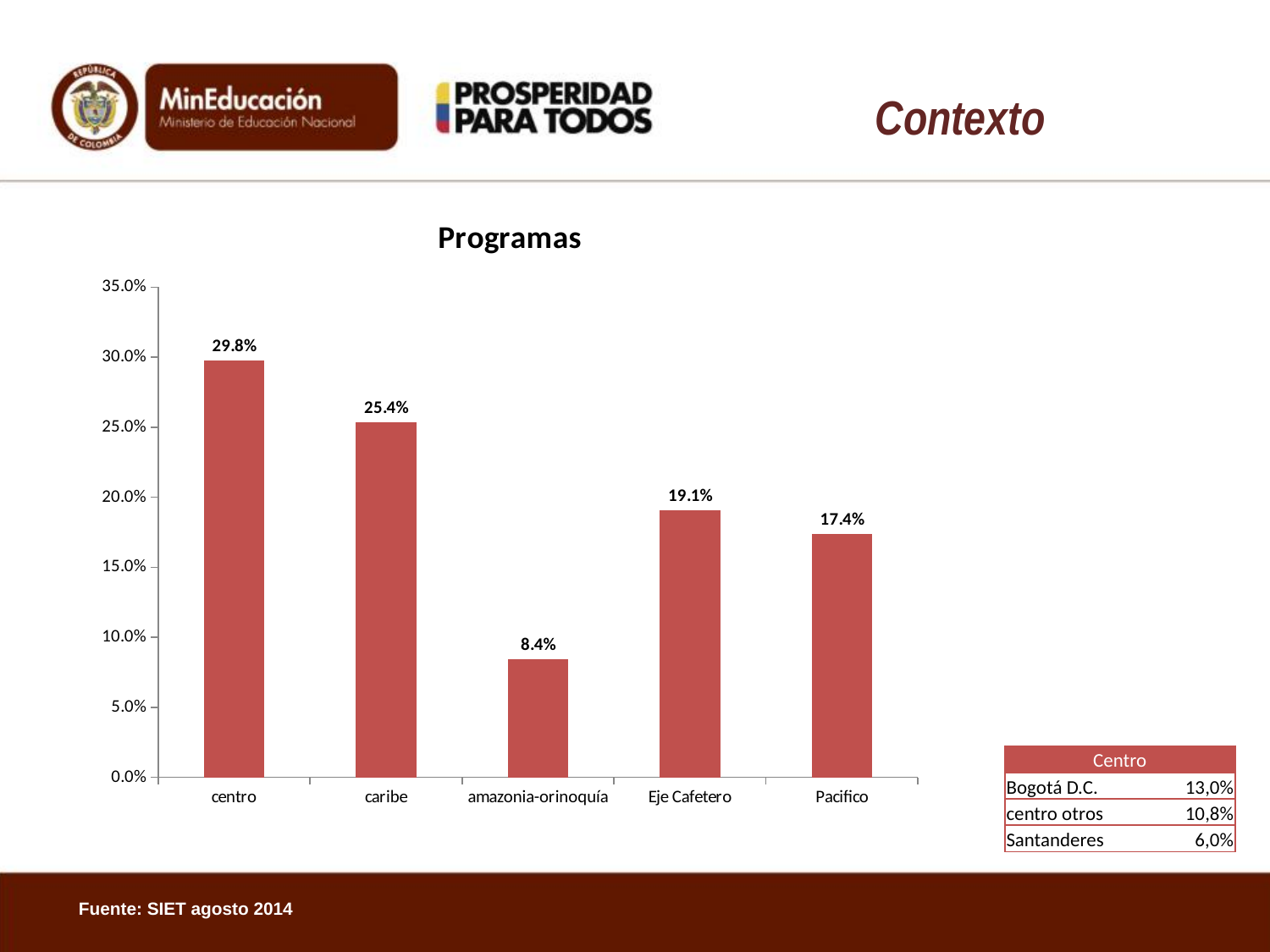
Which category has the highest value in the Programas chart? centro What is the difference between the values for centro and caribe in the Programas chart? 4.4% What is the value for amazonia-orinoquía in the Programas chart? 8.4% Which is larger in the Programas chart, caribe or Pacifico? caribe How many categories are shown in the Programas chart? 5 Is the value for Pacifico in the Programas chart greater or less than 20.0%? less What is the value for Eje Cafetero in the Programas chart? 19.1% What is the value for centro in the Programas chart? 29.8% What is the title of the chart on the slide? Programas Which category has the lowest value in the Programas chart? amazonia-orinoquía What kind of chart is the Programas chart? bar chart What is the difference between the values for Eje Cafetero and Pacifico in the Programas chart? 1.7%